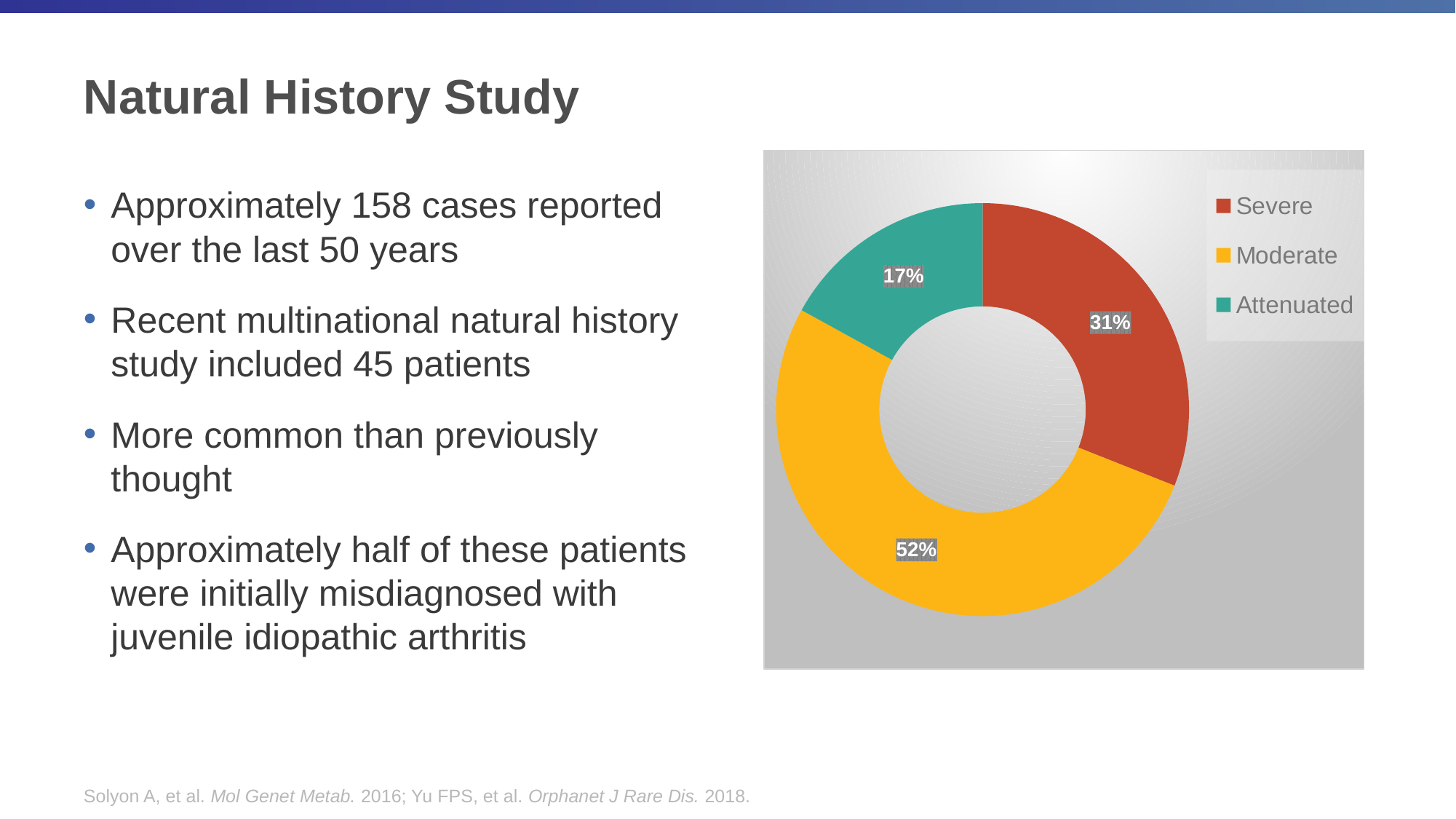
What kind of chart is shown on the slide? Doughnut chart How many categories does the chart show? 3 How many entries does the legend list? 3 What percentage of the chart is labelled Moderate? 52% Which category has the largest share of the chart? Moderate What is the difference in percentage points between the Severe and Attenuated shares? 14 What percentage of the chart is labelled Attenuated? 17% What colour represents the Moderate category in the chart? Yellow Which is larger, the Severe share or the Attenuated share? Severe Which category has the smallest share of the chart? Attenuated What is the difference in percentage points between the Moderate and Severe shares? 21 What percentage of the chart is labelled Severe? 31%